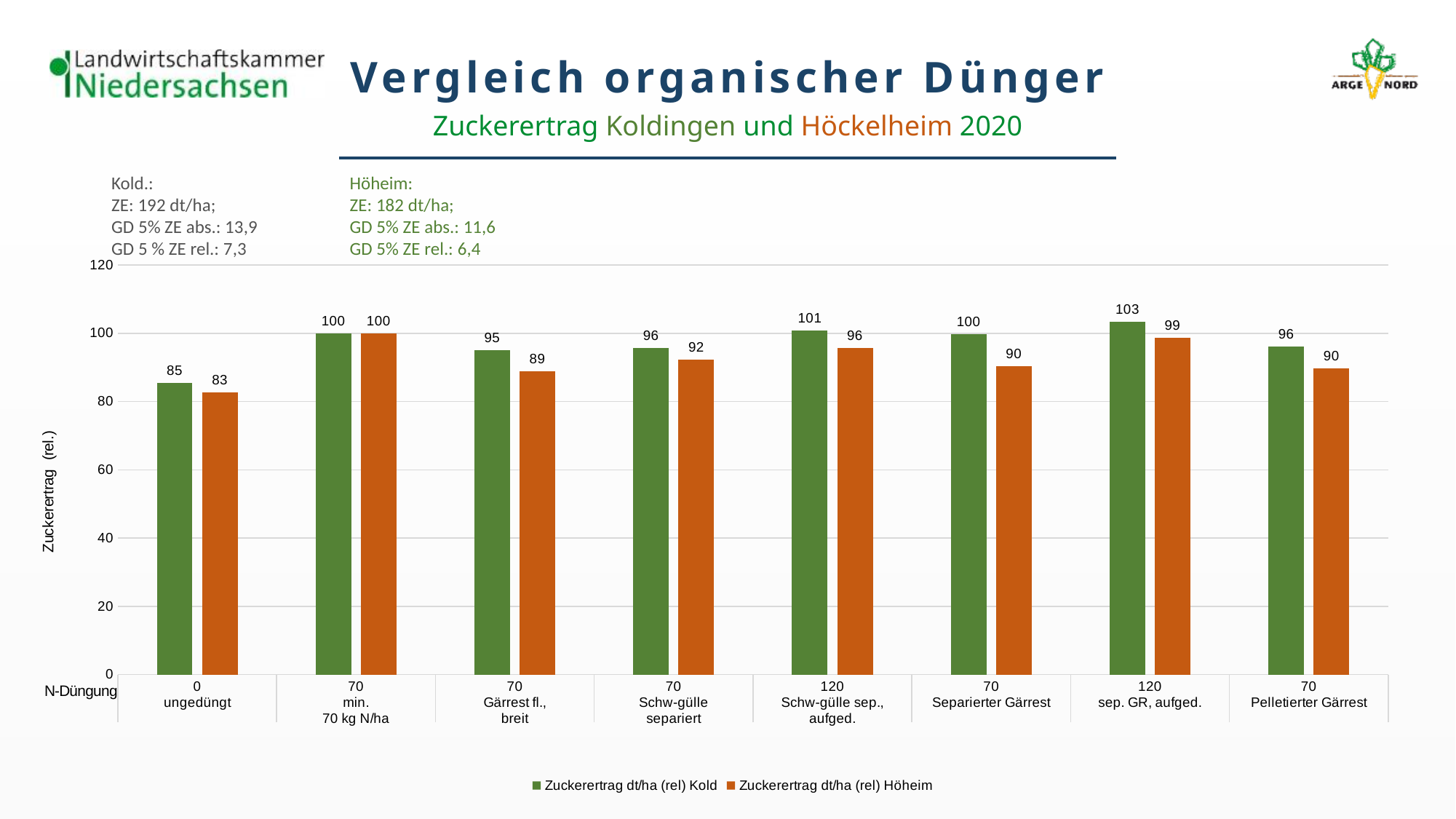
What is the y-axis label of the chart? Zuckerertrag (rel.) What kind of chart is shown on the slide? bar chart Which category has the lowest Höheim value? ungedüngt Which is larger for 'Schw-gülle separiert': the Kold value or the Höheim value? Kold What is the difference between the Kold and Höheim values for 'Separierter Gärrest'? 10 How many fertilizer categories are shown on the x axis? 8 How many series does the legend list? 2 Which category has the highest Kold value? sep. GR, aufged. Is the Höheim value for 'ungedüngt' greater or less than 100? less What is the Kold value for 'Pelletierter Gärrest'? 96 What is the Höheim value for 'Gärrest fl., breit'? 89 What is the Höheim value for 'Schw-gülle sep., aufged.'? 96